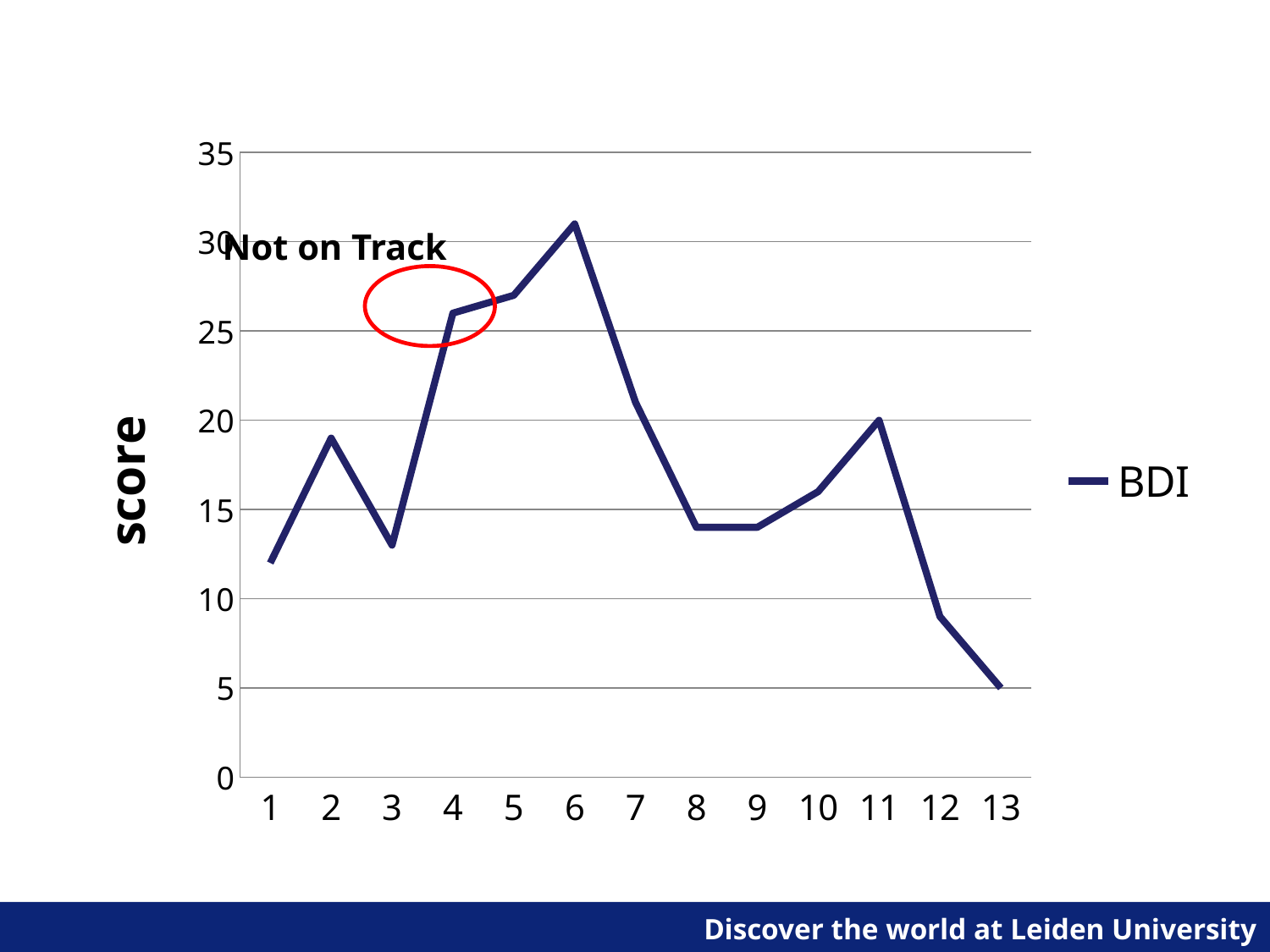
How many points are plotted along the x axis? 13 What is the BDI score at point 13? 5 What is the BDI score at point 11? 20 Which has a higher BDI score, point 2 or point 4? point 4 What is the name of the series shown in the legend? BDI Is the BDI score at point 12 greater or less than 10? less What kind of chart is shown on the slide? line chart Does the BDI score rise or fall from point 6 to point 8? fall At which x-axis point is the BDI score highest? 6 Is the BDI score at point 6 greater or less than 30? greater How many series does the legend list? 1 At which x-axis point is the BDI score lowest? 13